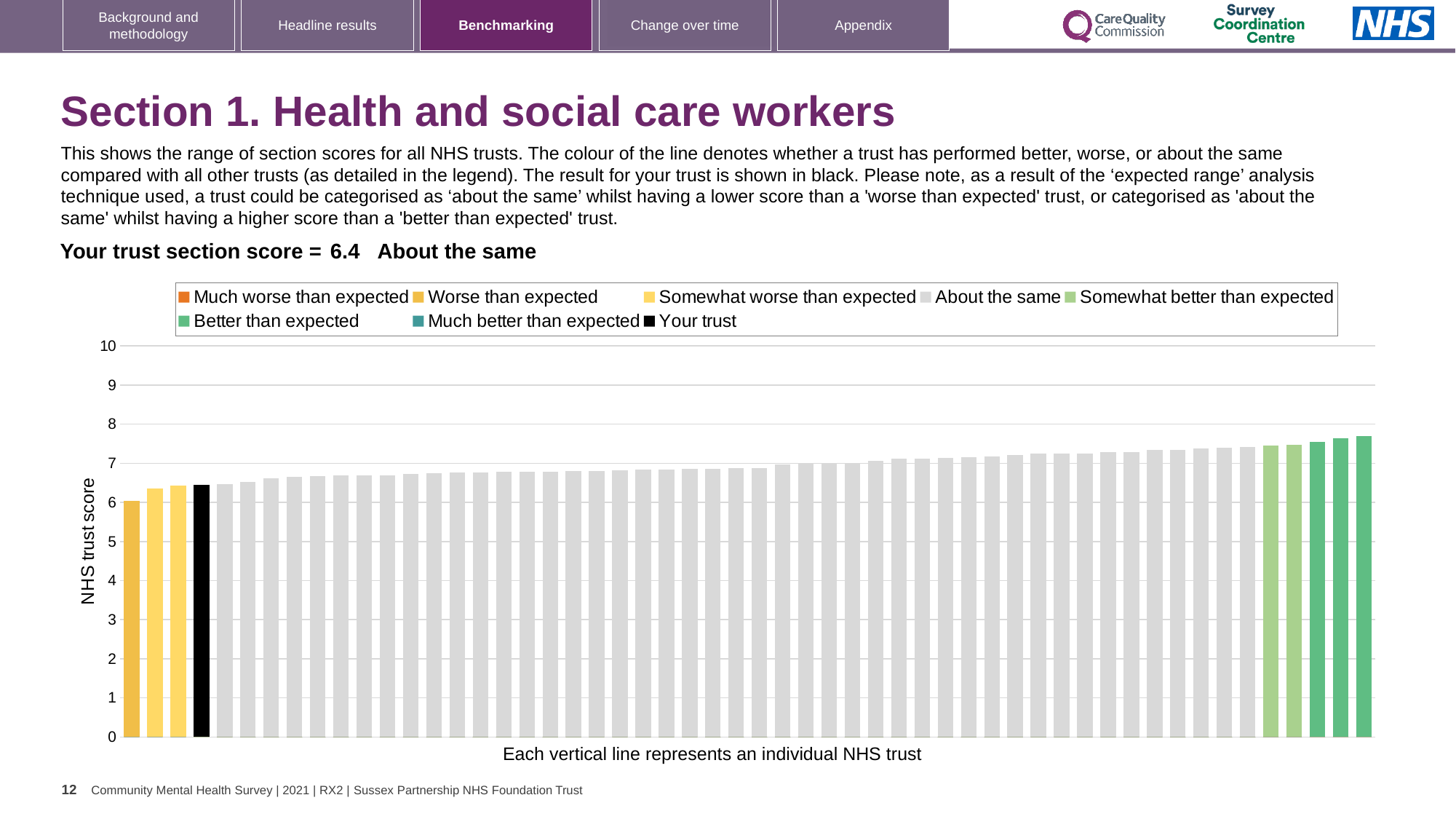
Is the value of the tallest bar greater or less than 8? less How many bars are coloured yellow (Somewhat worse than expected)? 2 What is the section score for your trust shown on the slide? 6.4 What colour is used for the bar representing your trust? black What kind of chart is shown on the slide? bar chart Do the bar values rise or fall from left to right along the x axis? rise What is the label on the vertical axis of the chart? NHS trust score Which performance category is your trust placed in for this section? About the same How many entries does the chart legend list? 8 Is the value for your trust (the black bar) greater or less than 7? less Is the value of the shortest bar greater or less than 5? greater Which is larger, the leftmost bar or the rightmost bar? the rightmost bar